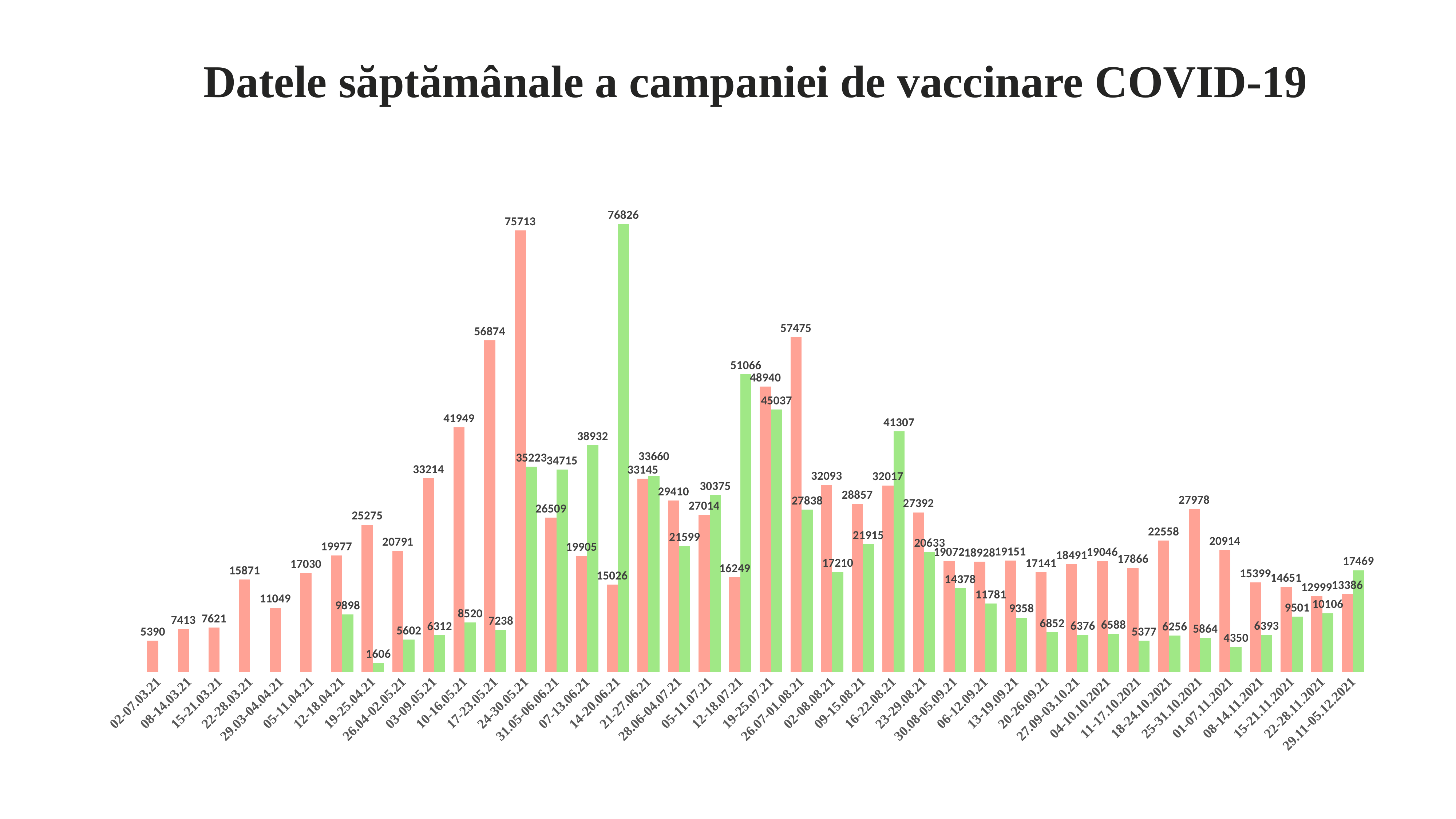
What is the value of the red bar for 24-30.05.21? 75713 Which week has the lowest red bar? 02-07.03.21 How many weeks are shown on the x axis? 40 What is the difference between the red bars for 24-30.05.21 and 17-23.05.21? 18839 Which week has the highest red bar? 24-30.05.21 What type of chart is shown on the slide? bar chart Which week has the highest green bar? 14-20.06.21 For 12-18.07.21, which bar is larger, the red or the green? green Which week has the lowest green bar? 19-25.04.21 What is the value of the red bar for 02-07.03.21? 5390 What is the difference between the green and red bars for 29.11-05.12.2021? 4083 What is the value of the green bar for 14-20.06.21? 76826